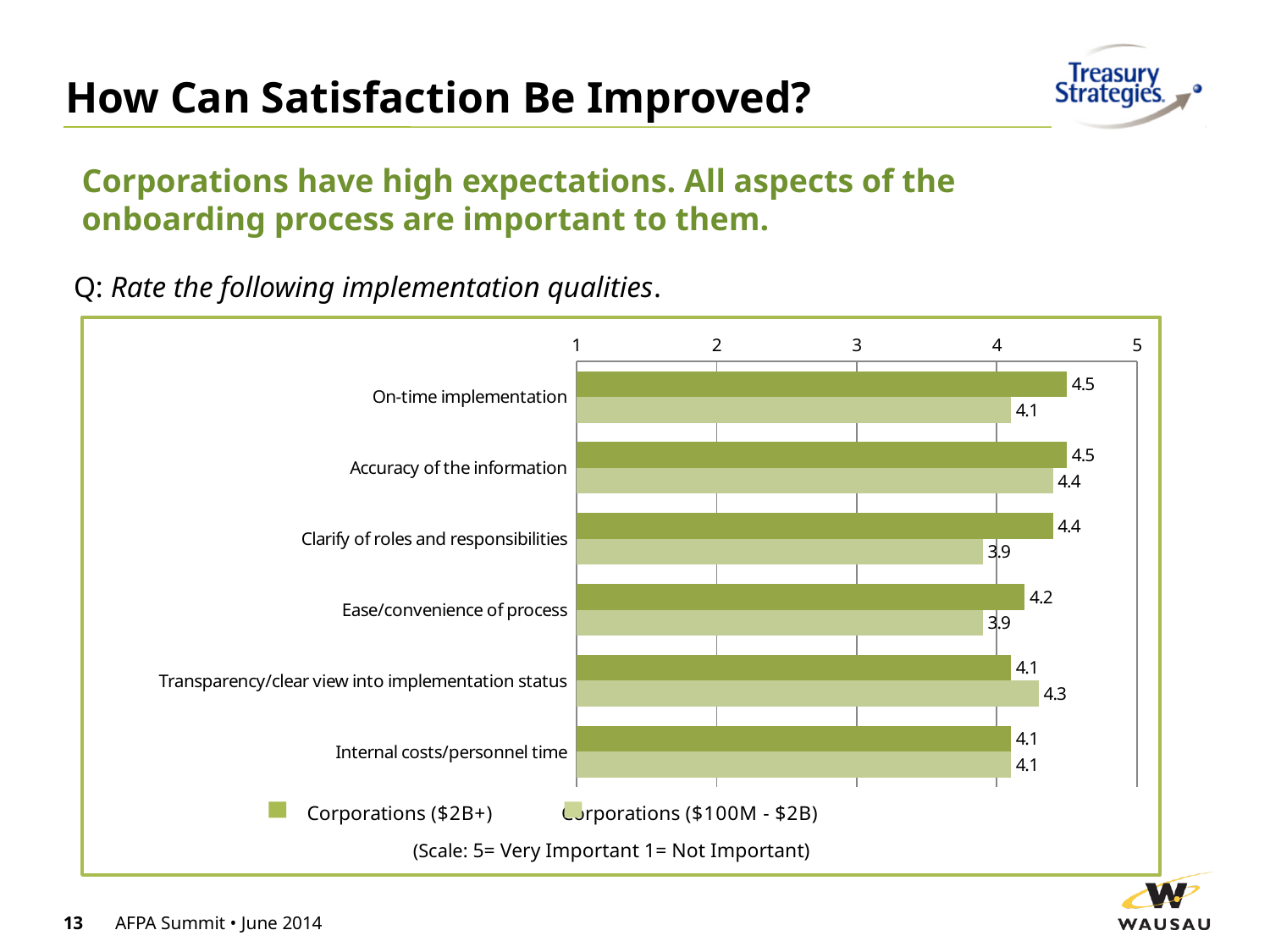
What is the value for Corporations ($2B+) for On-time implementation? 4.5 What is the difference between the Corporations ($2B+) and Corporations ($100M - $2B) values for On-time implementation? 0.4 For Transparency/clear view into implementation status, which series has the larger value: Corporations ($2B+) or Corporations ($100M - $2B)? Corporations ($100M - $2B) What does the scale note below the chart say 5 represents? Very Important How many series does the legend list? 2 What kind of chart is shown on the slide? bar chart What is the difference between the Corporations ($2B+) and Corporations ($100M - $2B) values for Clarify of roles and responsibilities? 0.5 What is the value for Corporations ($100M - $2B) for Transparency/clear view into implementation status? 4.3 Which implementation quality has the highest value for Corporations ($100M - $2B)? Accuracy of the information What is the value for Corporations ($100M - $2B) for Clarify of roles and responsibilities? 3.9 For Ease/convenience of process, which series has the larger value: Corporations ($2B+) or Corporations ($100M - $2B)? Corporations ($2B+) How many implementation qualities are plotted on the chart? 6